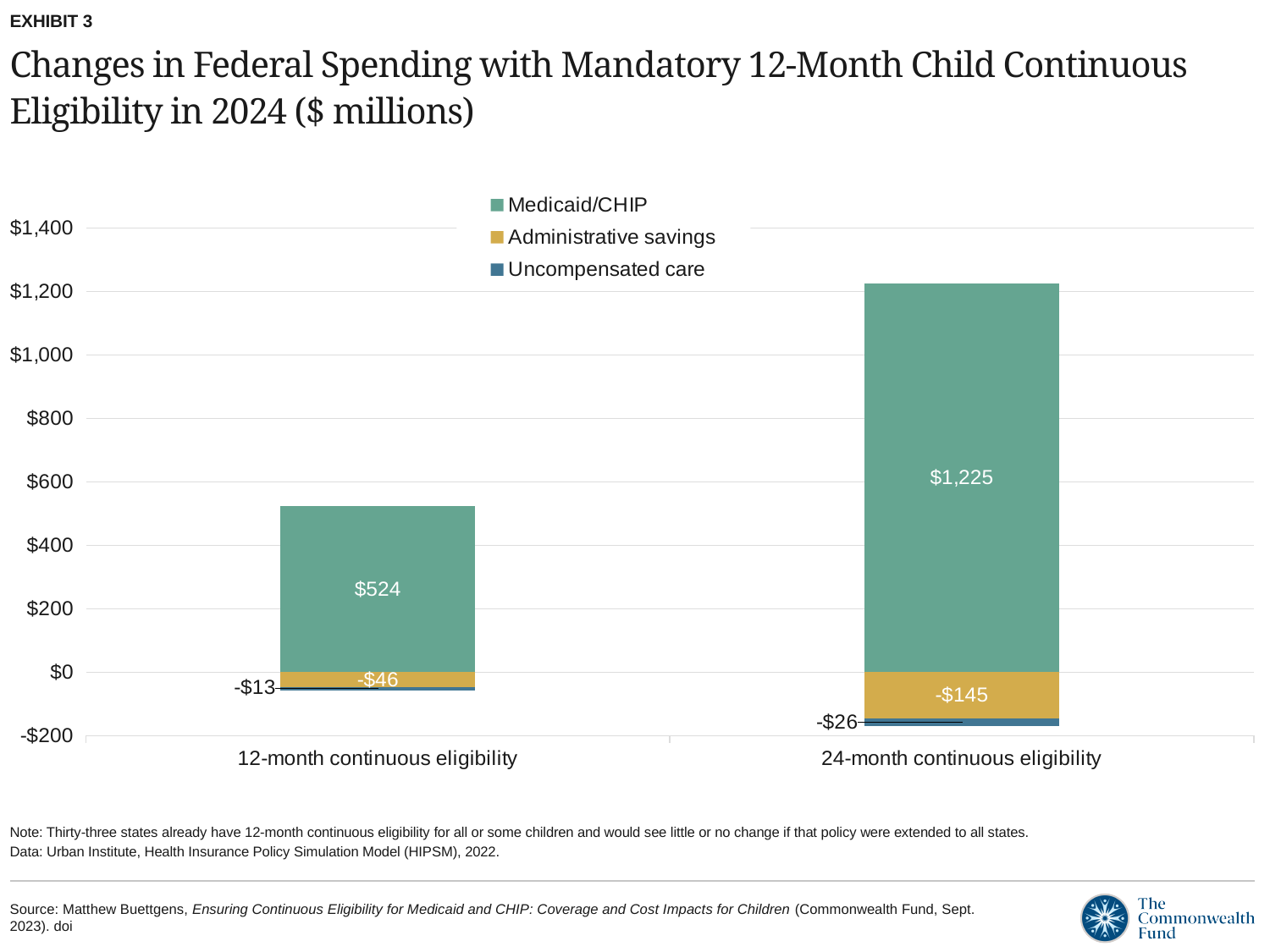
Is the Medicaid/CHIP value for 24-month continuous eligibility greater or less than $1,000? greater What is the Administrative savings value for 12-month continuous eligibility? -$46 What is the difference between the Medicaid/CHIP values for 24-month and 12-month continuous eligibility? $701 What kind of chart is shown on the slide? Stacked bar chart What is the Medicaid/CHIP value for 12-month continuous eligibility? $524 How many categories are shown on the x axis? 2 What is the Uncompensated care value for 24-month continuous eligibility? -$26 Which category has the higher Medicaid/CHIP value? 24-month continuous eligibility What is the Administrative savings value for 24-month continuous eligibility? -$145 How many series does the legend list? 3 What is the Uncompensated care value for 12-month continuous eligibility? -$13 What is the Medicaid/CHIP value for 24-month continuous eligibility? $1,225